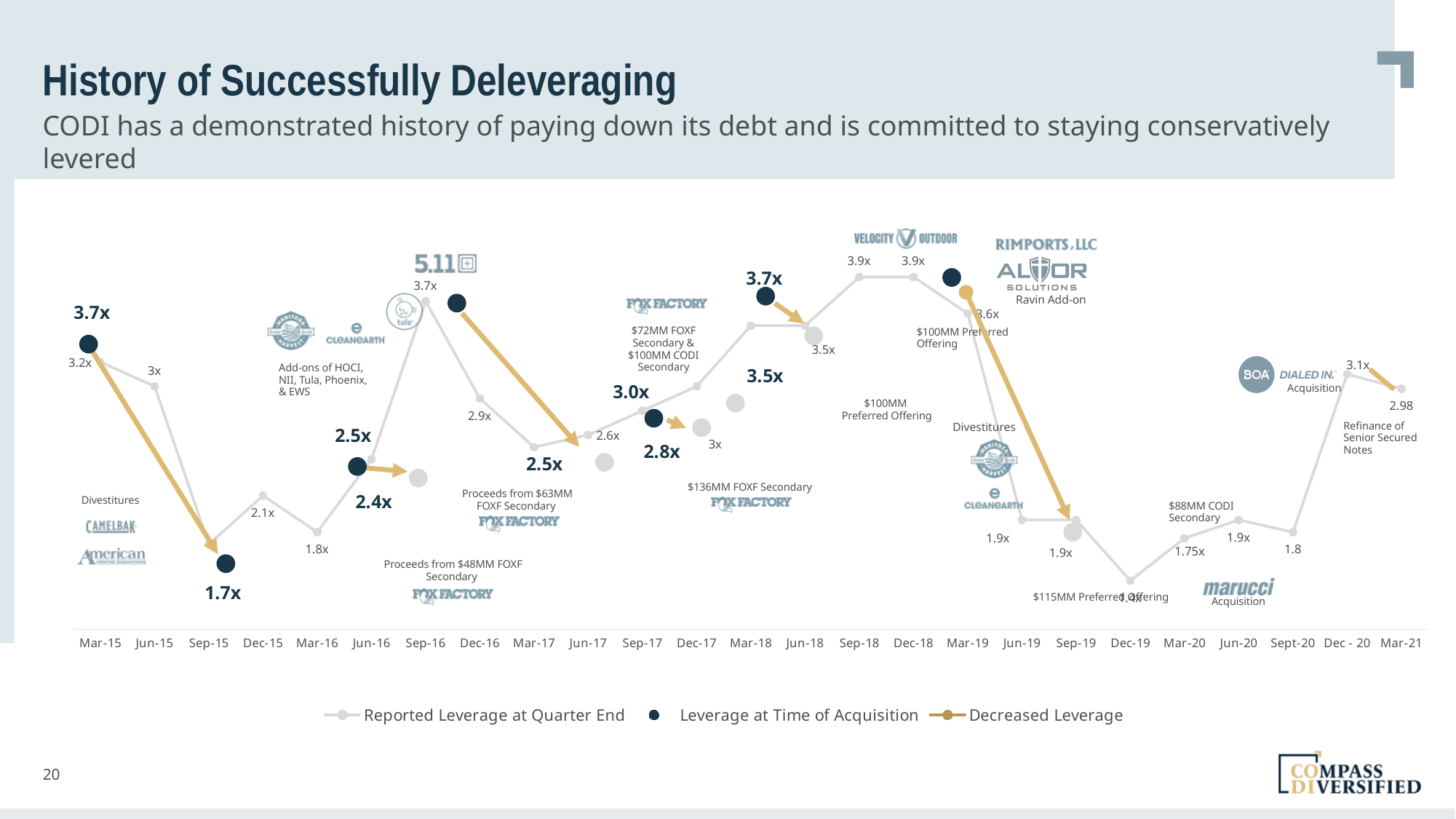
Which quarter has the higher reported leverage at quarter end, Sep-16 or Dec-16? Sep-16 What kind of chart is shown on the slide? line chart Which quarter has the lowest reported leverage at quarter end? Dec-19 What is the difference between the reported leverage at Sep-18 and at Jun-19? 2.0x What is the reported leverage at quarter end for Dec-20? 3.1x What is the reported leverage at quarter end for Sep-18? 3.9x How many quarters are shown on the x axis? 25 What is the reported leverage at quarter end for Mar-15? 3.2x What is the reported leverage at quarter end for Mar-20? 1.75x What is the reported leverage at quarter end for Mar-21? 2.98 What does the legend call the series drawn with gold arrows? Decreased Leverage How many series does the legend list? 3